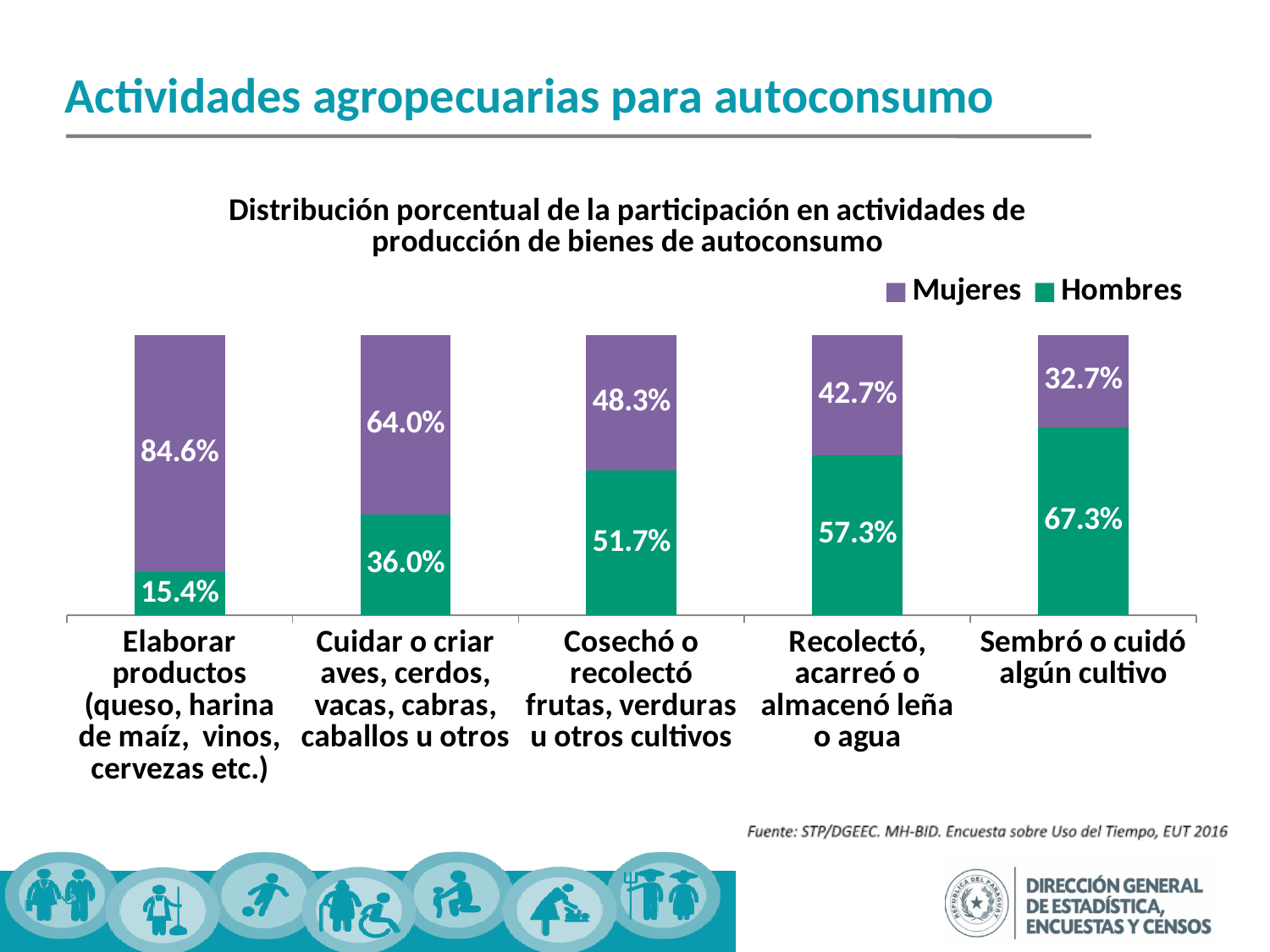
Which colour represents the Hombres series in the chart? Green Which activity has the highest Mujeres share? Elaborar productos (queso, harina de maíz, vinos, cervezas etc.) What is the Mujeres value for 'Cosechó o recolectó frutas, verduras u otros cultivos'? 48.3% What is the difference between the Mujeres and Hombres values for 'Cuidar o criar aves, cerdos, vacas, cabras, caballos u otros'? 28.0% What is the total of the stacked bar for 'Sembró o cuidó algún cultivo'? 100.0% For 'Recolectó, acarreó o almacenó leña o agua', which is larger, the Mujeres or the Hombres value? Hombres How many activity categories are shown on the x axis? 5 What kind of chart is shown on the slide? Stacked bar chart Which activity has the lowest Hombres share? Elaborar productos (queso, harina de maíz, vinos, cervezas etc.) How many series does the legend list? 2 What percentage of women (Mujeres) participate in 'Elaborar productos (queso, harina de maíz, vinos, cervezas etc.)'? 84.6% What is the Hombres value for 'Sembró o cuidó algún cultivo'? 67.3%